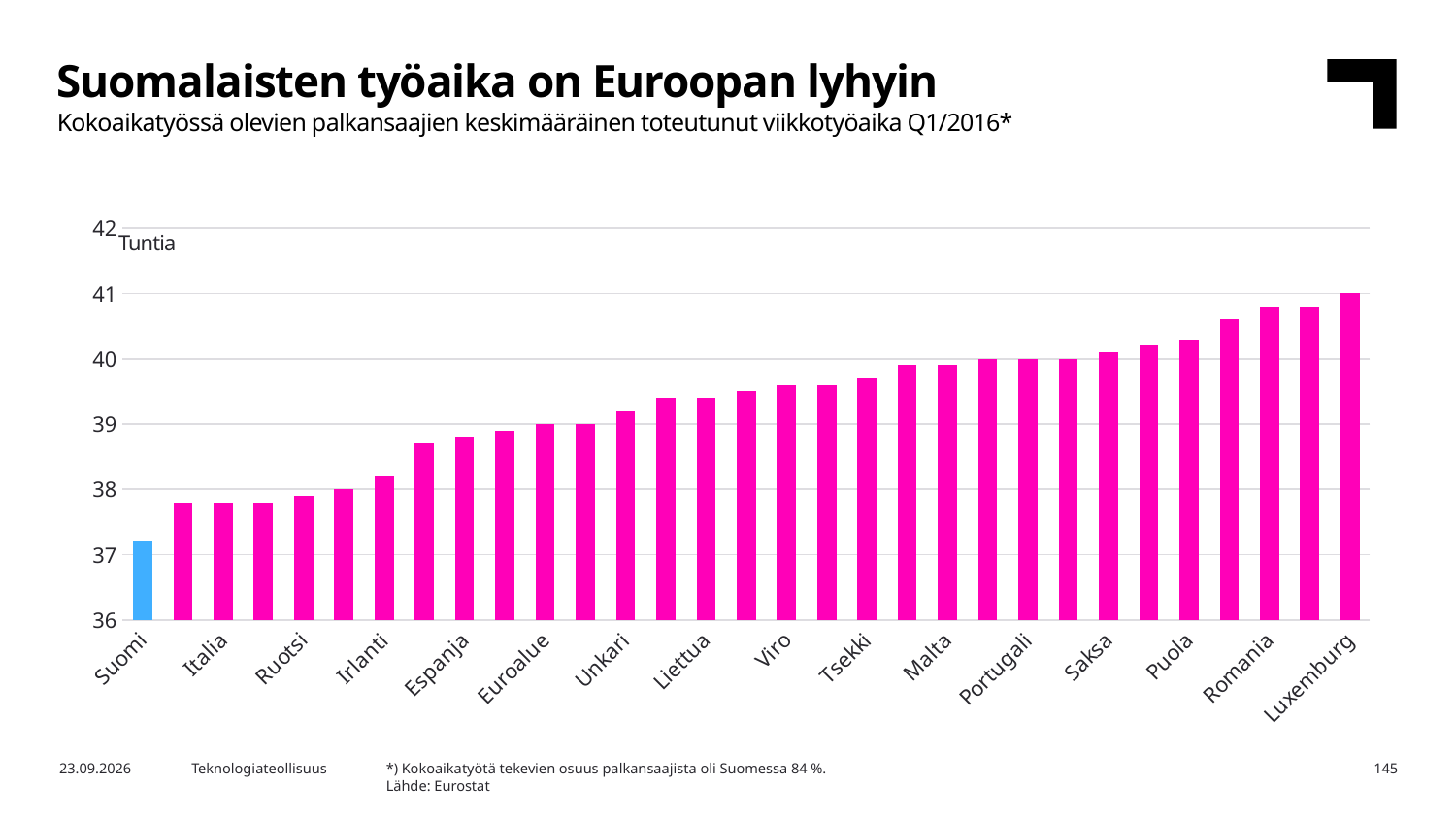
Which country has the highest average weekly working time in the chart? Luxemburg Is the value for Suomi greater or less than 37? greater Is the value for Suomi greater or less than 38? less Do the values rise or fall moving from left to right along the x axis? rise Which has a larger value, Italia or Romania? Romania What unit is shown at the top of the y axis? Tuntia Is the value for Luxemburg greater or less than 40? greater What kind of chart is shown on the slide? bar chart Which country has the lowest average weekly working time in the chart? Suomi